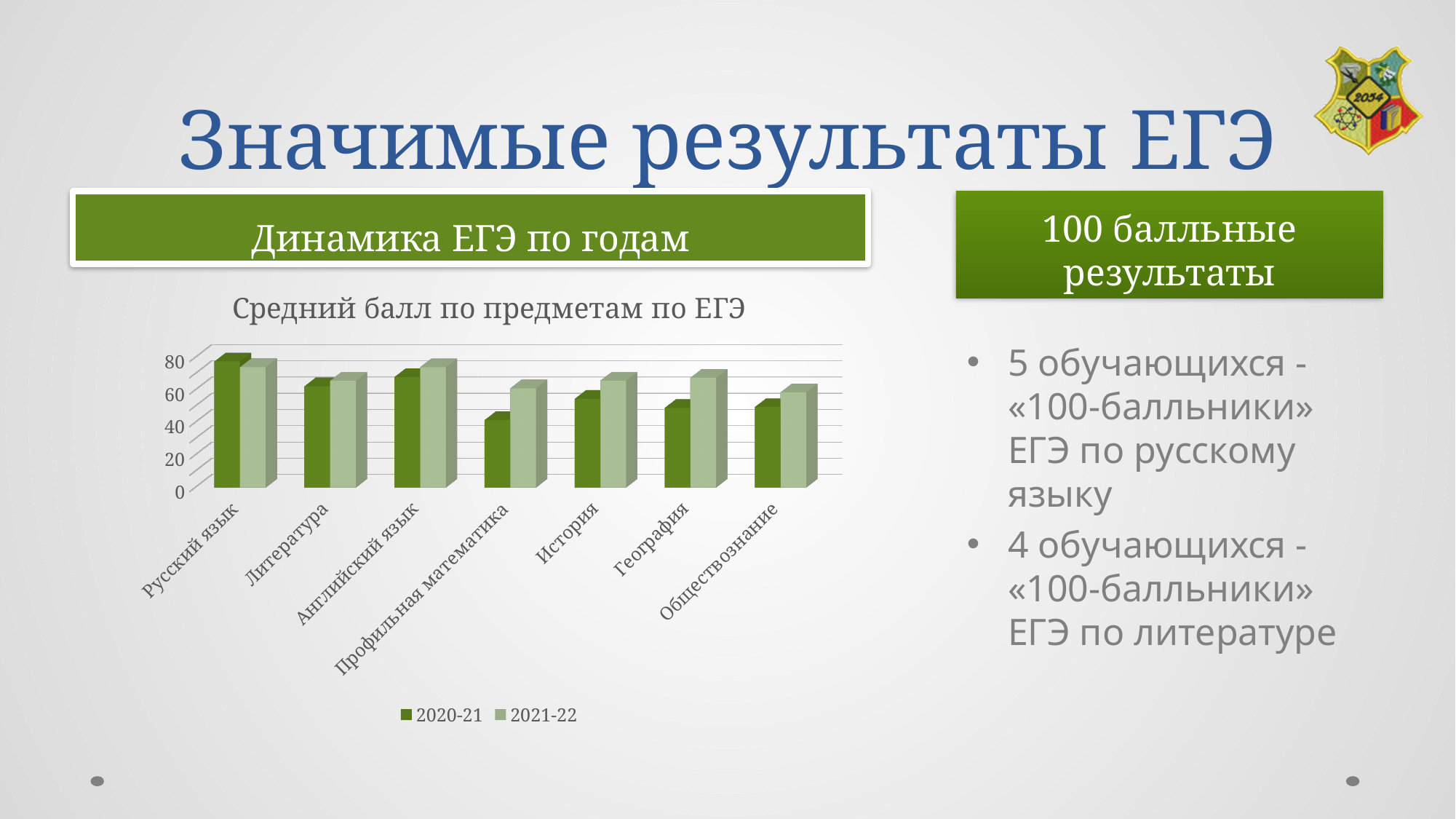
For Профильная математика, which series has the larger value, 2020-21 or 2021-22? 2021-22 What are the two series named in the chart's legend? 2020-21 and 2021-22 Which subject has the highest value for the 2020-21 series? Русский язык Is the 2020-21 value for Русский язык greater or less than 60? greater Is the 2020-21 value for Профильная математика greater or less than 60? less What kind of chart is shown under "Динамика ЕГЭ по годам"? Bar chart What is the title of the chart on the slide? Средний балл по предметам по ЕГЭ For География, which series has the larger value, 2020-21 or 2021-22? 2021-22 Which subject has the lowest value for the 2020-21 series? Профильная математика Is the 2021-22 value for Профильная математика greater or less than 40? greater How many series does the chart's legend list? 2 How many subjects (categories) are shown on the x axis of the chart? 7